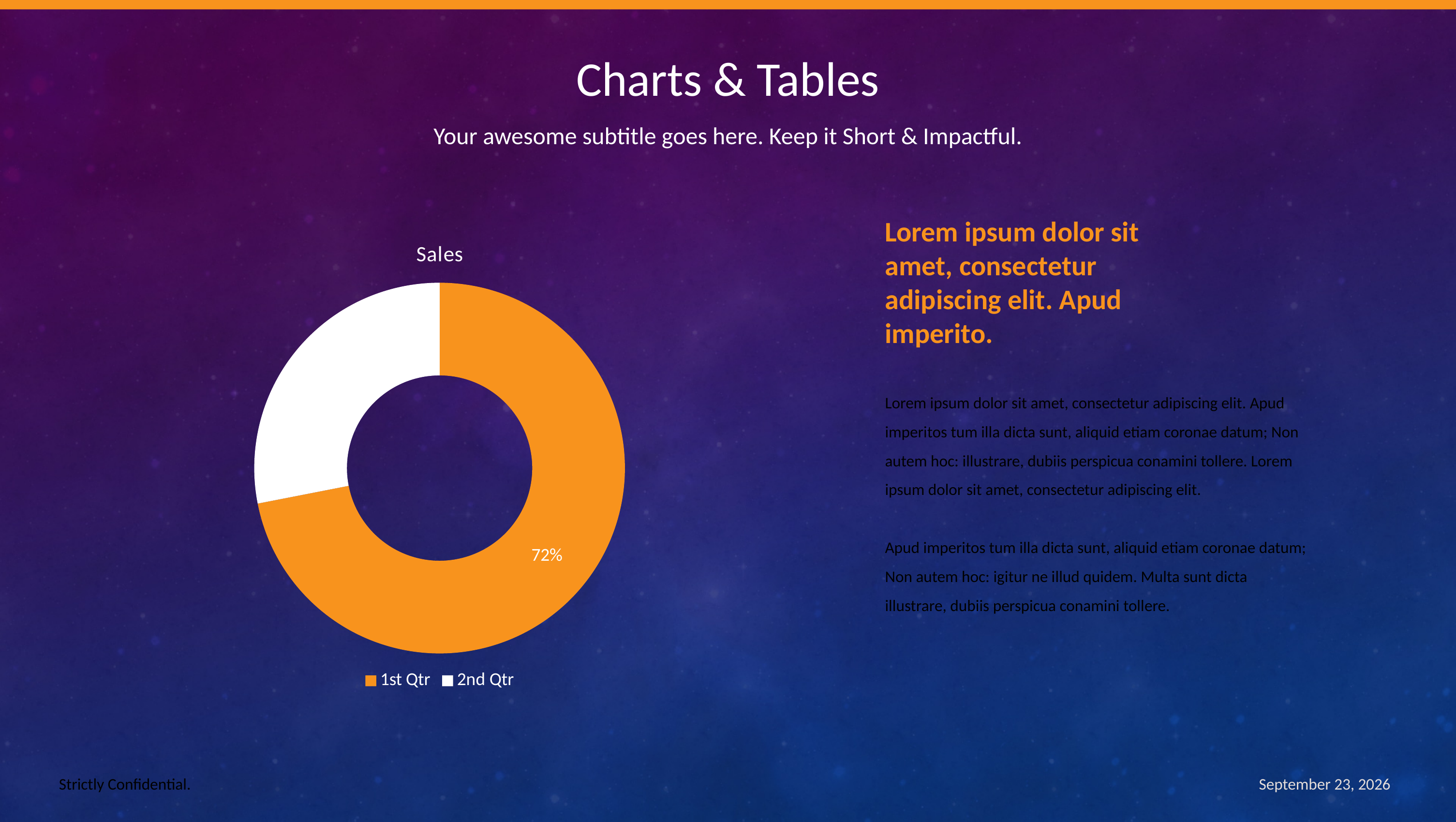
What percentage is shown for 1st Qtr in the Sales chart? 72% Which is larger in the Sales chart, 1st Qtr or 2nd Qtr? 1st Qtr What share of the Sales chart does the 1st Qtr slice take? 72% What colour represents 1st Qtr in the Sales chart? orange What is the title of the chart? Sales What kind of chart is shown on the slide? doughnut chart How many categories does the Sales chart show? 2 How many entries does the legend of the Sales chart list? 2 Which category has the largest slice in the Sales chart? 1st Qtr Which category has the smallest slice in the Sales chart? 2nd Qtr